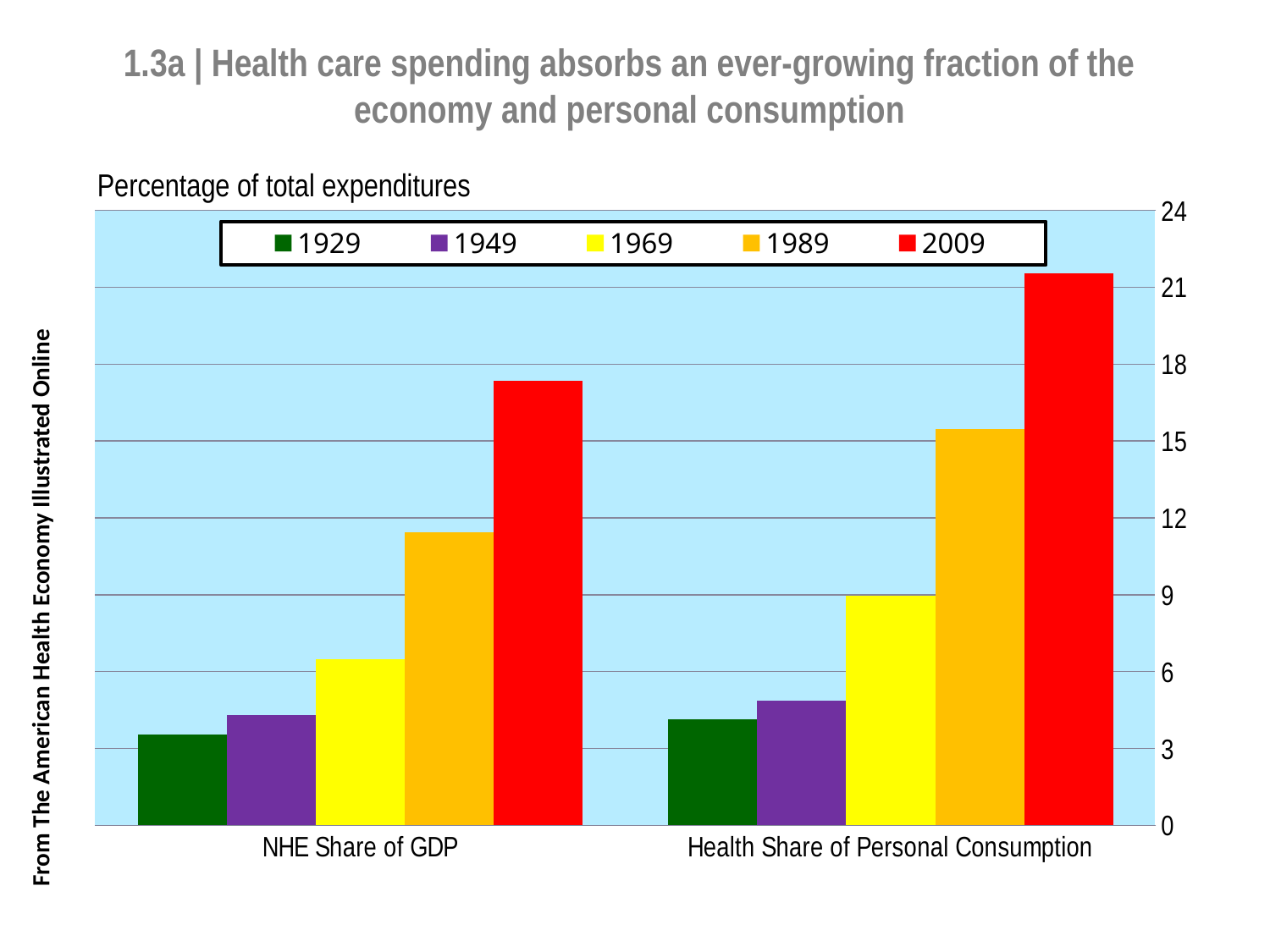
Which year has the highest value for NHE Share of GDP? 2009 Is the value for 2009 in NHE Share of GDP greater or less than 18? less What colour represents the 1989 series in the legend? orange How many series does the legend list? 5 Is the value for 1989 in Health Share of Personal Consumption greater or less than 15? greater How many categories are shown on the x axis? 2 What kind of chart is shown on the slide? bar chart Which year has the lowest value for Health Share of Personal Consumption? 1929 Do the values for NHE Share of GDP rise or fall from 1929 to 2009? rise Is the value for 2009 in Health Share of Personal Consumption greater or less than 21? greater Which is larger: the 1969 value for NHE Share of GDP or the 1969 value for Health Share of Personal Consumption? Health Share of Personal Consumption